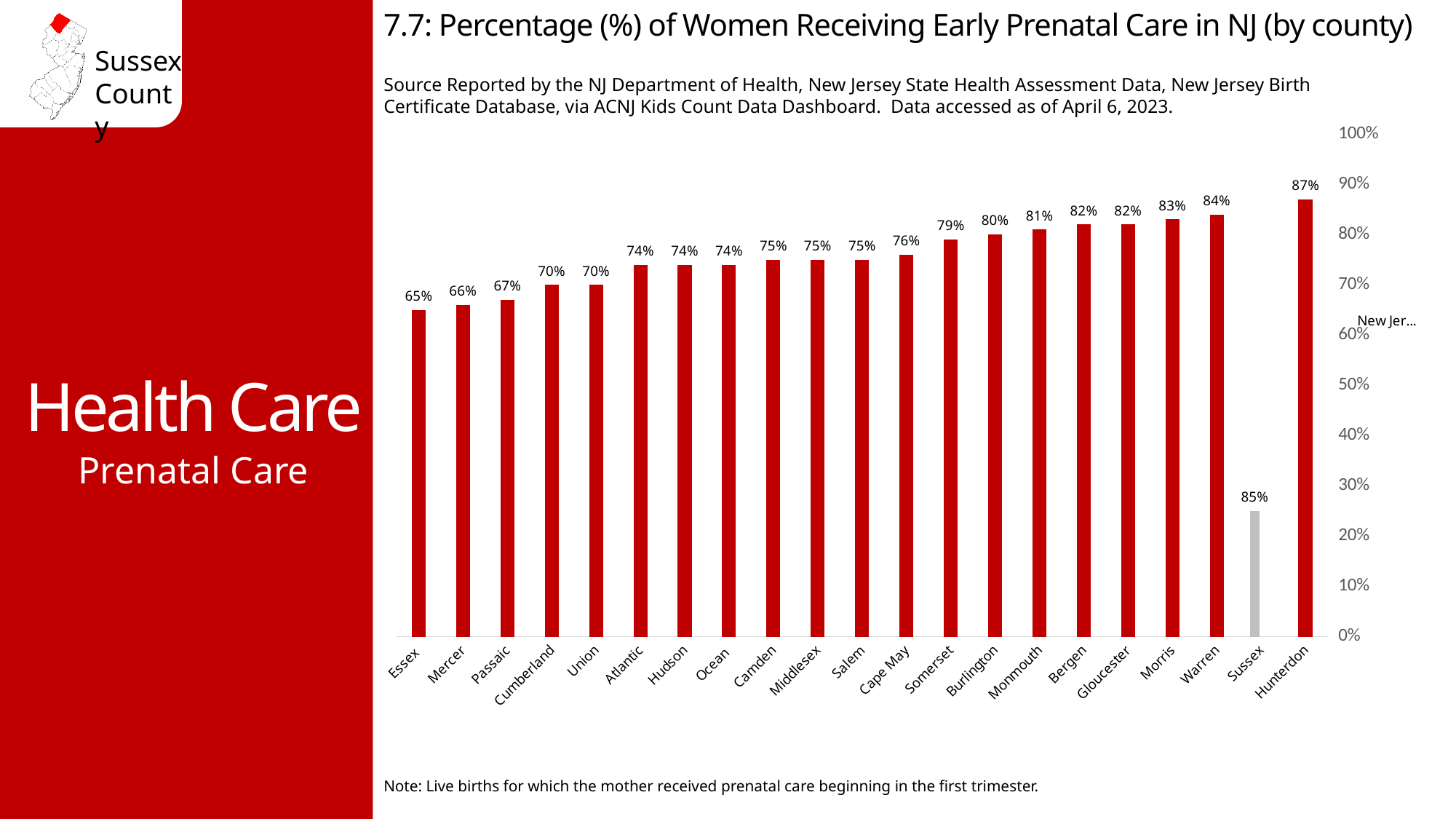
Which county's bar is shown in gray rather than red? Sussex How many counties are shown on the chart? 21 What percentage of women received early prenatal care in Hunterdon county? 87% What percentage is shown for Essex county? 65% Which county has the lowest percentage of women receiving early prenatal care? Essex Which county has the highest percentage of women receiving early prenatal care? Hunterdon What kind of chart is shown on the slide? bar chart Is the value for Mercer county greater or less than 70%? less What is the value shown for Sussex county? 85% What is the value for Somerset county? 79% Which county has a higher value, Bergen or Cumberland? Bergen What is the difference in percentage points between Hunterdon and Essex? 22